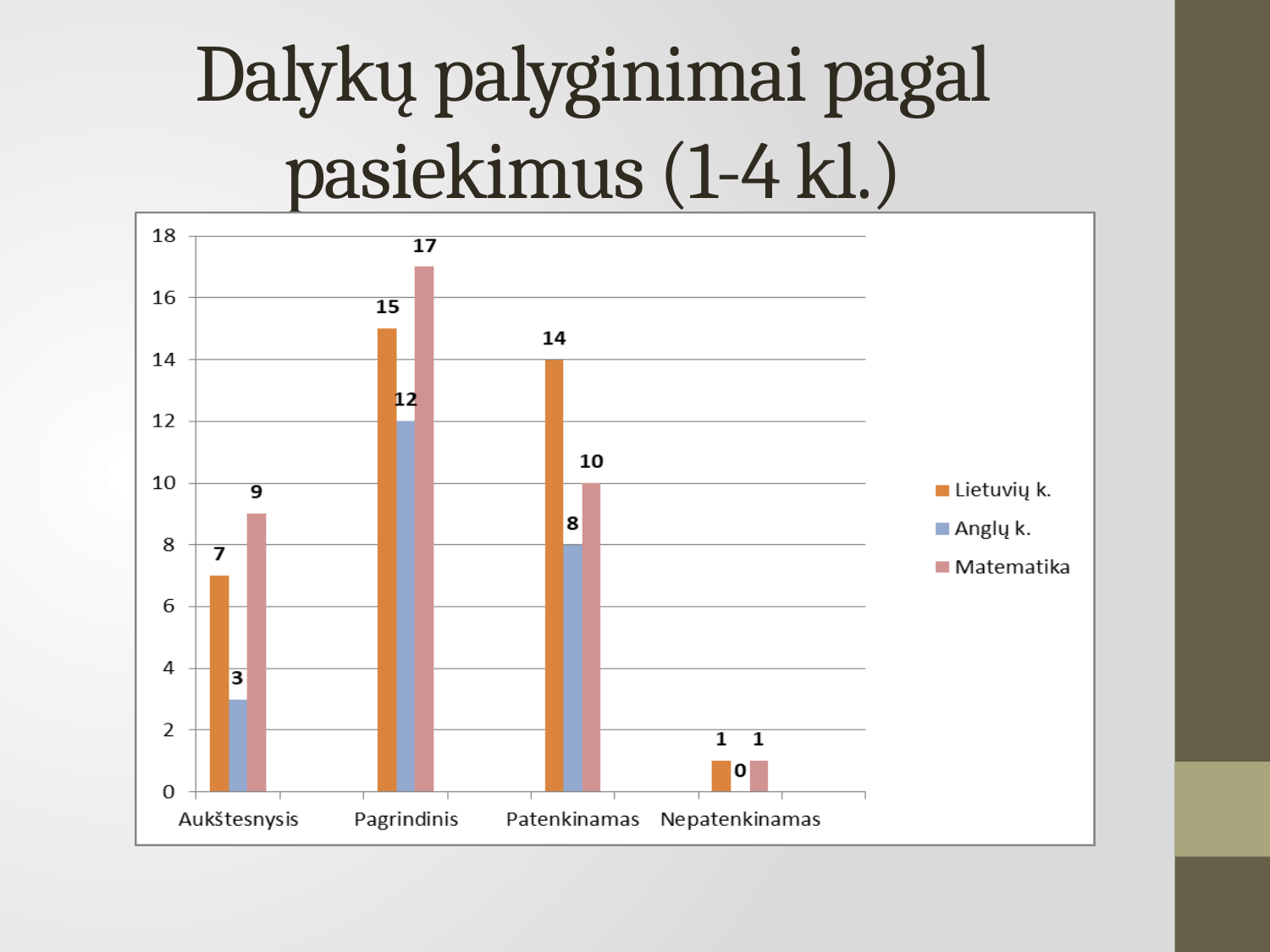
What is the difference between the Matematika and Anglų k. values in the Pagrindinis category? 5 Which is larger in the Patenkinamas category: Lietuvių k. or Matematika? Lietuvių k. Which category has the highest value for Matematika? Pagrindinis How many series does the legend list? 3 How many categories are shown on the x axis? 4 What is the value for Anglų k. in the Nepatenkinamas category? 0 What is the title of the slide? Dalykų palyginimai pagal pasiekimus (1-4 kl.) What is the value for Matematika in the Patenkinamas category? 10 What kind of chart is shown on the slide? Bar chart What is the value for Lietuvių k. in the Pagrindinis category? 15 What is the value for Anglų k. in the Aukštesnysis category? 3 Which category has the lowest value for Lietuvių k.? Nepatenkinamas